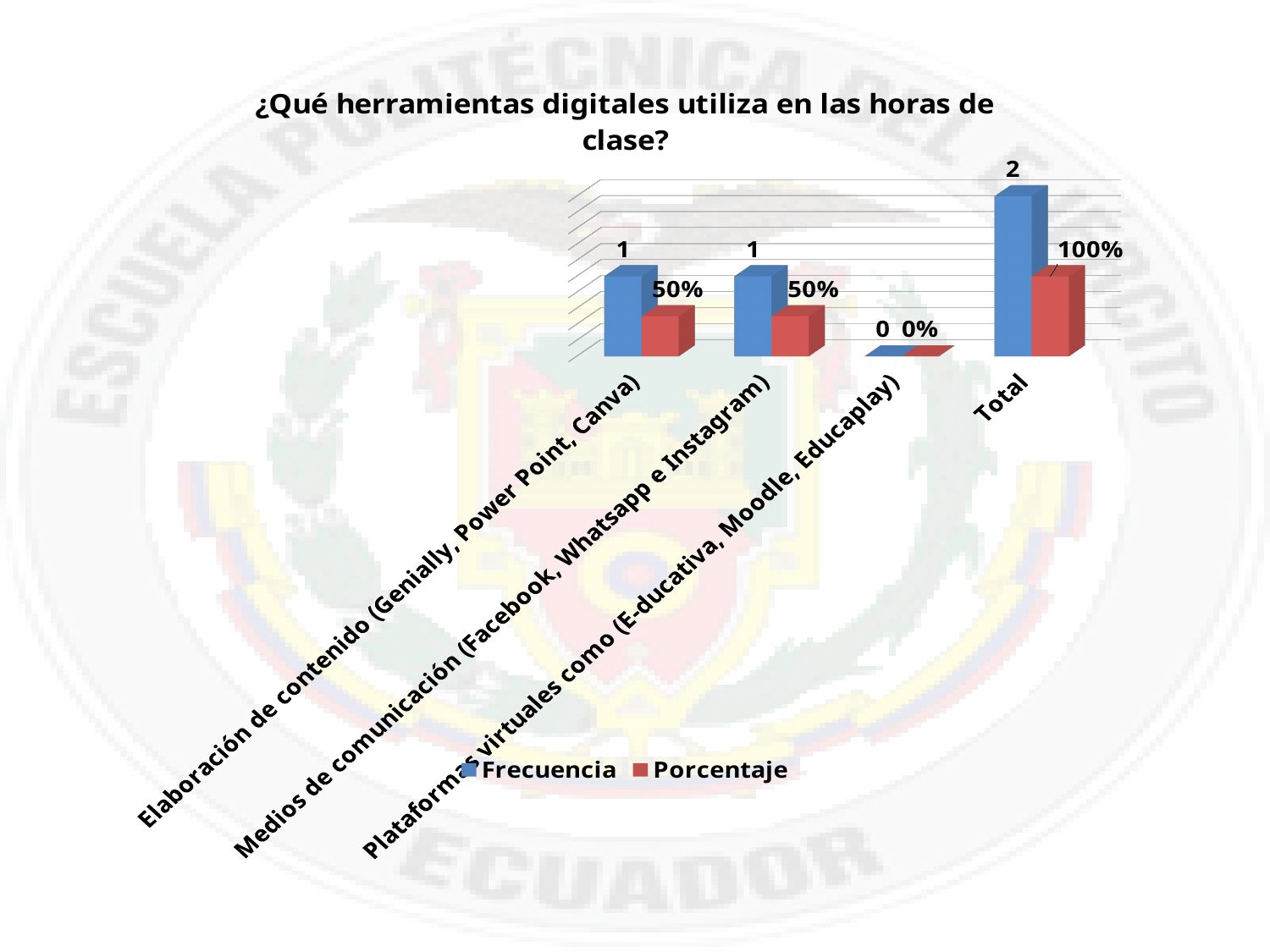
What kind of chart is shown on the slide? Bar chart What is the title of the chart? ¿Qué herramientas digitales utiliza en las horas de clase? How many categories are shown on the x axis of the chart? 4 What is the Porcentaje value for Total? 100% What is the Porcentaje value for Medios de comunicación (Facebook, Whatsapp e Instagram)? 50% Which category has the highest Frecuencia value? Total Which category has the lowest Porcentaje value? Plataformas virtuales como (E-ducativa, Moodle, Educaplay) What is the difference between the Frecuencia value for Total and the Frecuencia value for Elaboración de contenido (Genially, Power Point, Canva)? 1 How many series does the legend list? 2 Which is larger: the Porcentaje value for Medios de comunicación (Facebook, Whatsapp e Instagram) or the Porcentaje value for Plataformas virtuales como (E-ducativa, Moodle, Educaplay)? Medios de comunicación (Facebook, Whatsapp e Instagram) What is the Frecuencia value for Elaboración de contenido (Genially, Power Point, Canva)? 1 What is the Frecuencia value for Plataformas virtuales como (E-ducativa, Moodle, Educaplay)? 0